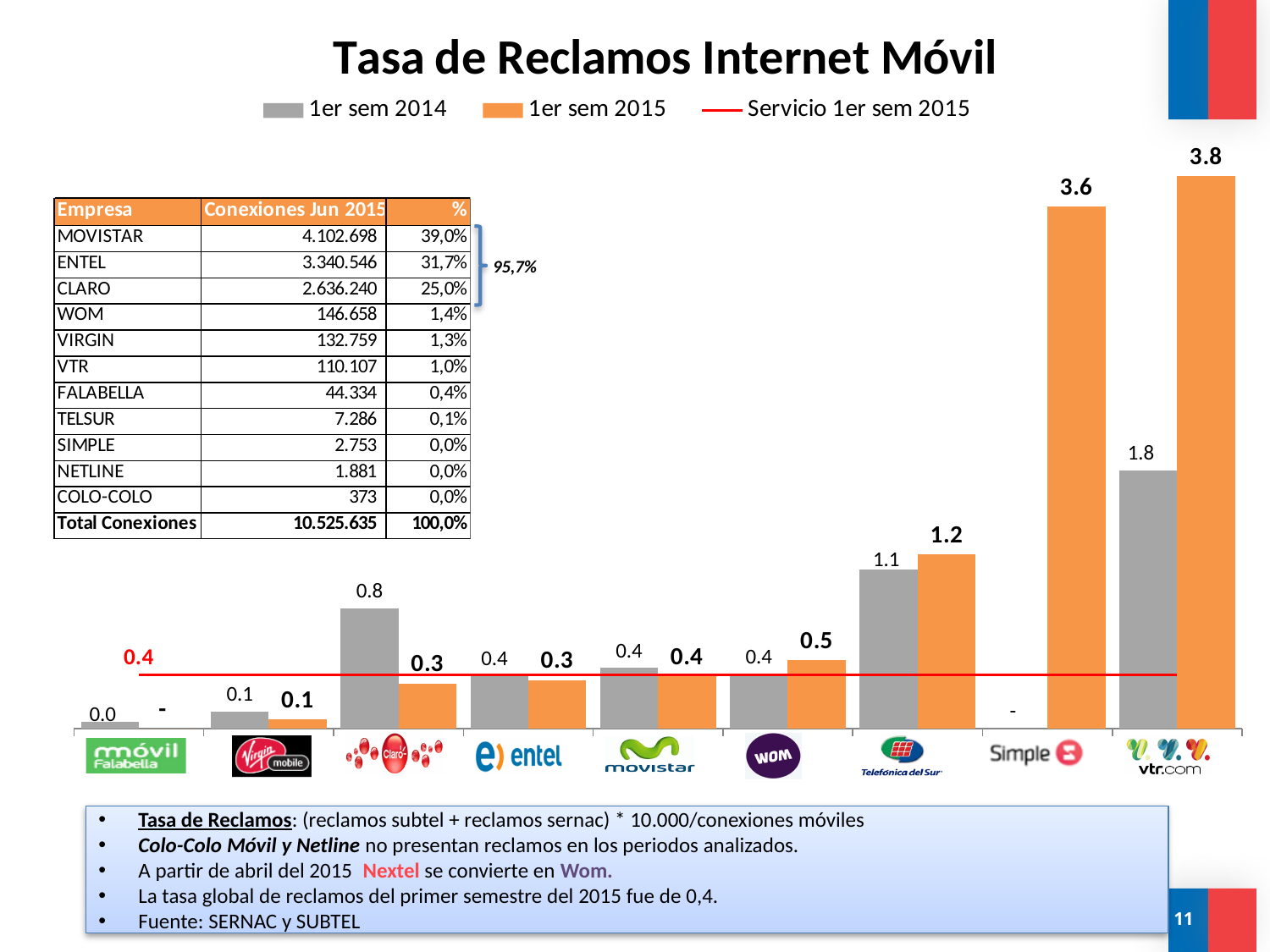
What value does the red 'Servicio 1er sem 2015' line mark on the chart? 0.4 Which company has the highest 1er sem 2014 value? VTR How many series does the chart legend list? 3 Which company has the highest 1er sem 2015 value? VTR What is the 1er sem 2015 value for VTR? 3.8 Which is larger for Claro: the 1er sem 2014 value or the 1er sem 2015 value? 1er sem 2014 What is the 1er sem 2014 value for Telefónica del Sur? 1.1 What is the 1er sem 2014 value for Claro? 0.8 What is the 1er sem 2015 value for Simple? 3.6 What is the difference between the 1er sem 2015 and 1er sem 2014 values for VTR? 2.0 What type of chart is shown on the slide? combination bar and line chart How many companies are shown on the x axis of the chart? 9